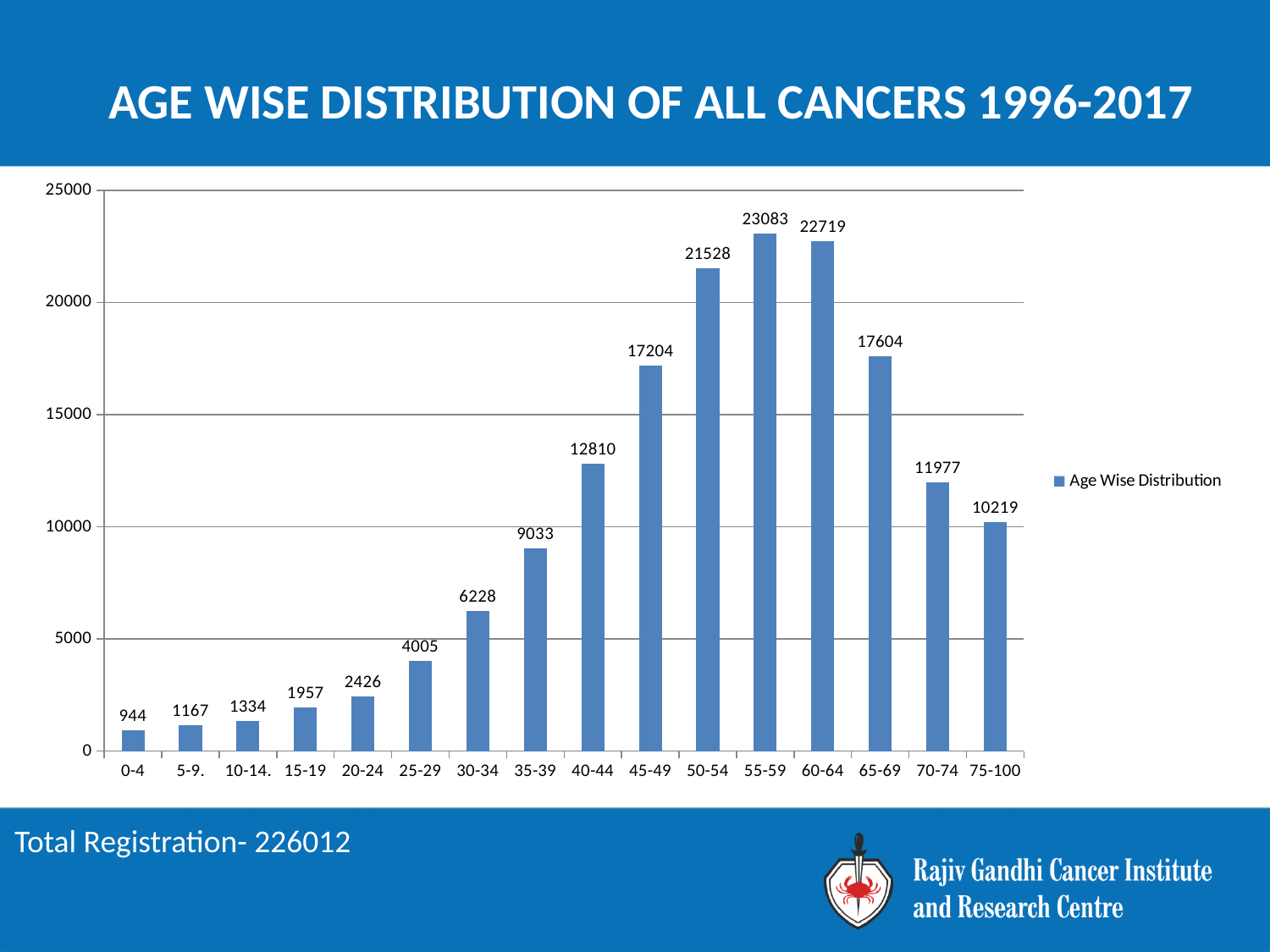
Which is larger, the value for 45-49 or the value for 65-69? 65-69 What is the value for the 0-4 age group? 944 What is the value for the 55-59 age group? 23083 Which age group has the lowest value? 0-4 What is the difference between the values for 55-59 and 60-64? 364 Is the value for 40-44 greater or less than 10000? greater What is the title of the chart? AGE WISE DISTRIBUTION OF ALL CANCERS 1996-2017 What kind of chart is shown on the slide? bar chart How many series does the legend list? 1 What is the value for the 75-100 age group? 10219 How many age groups are shown on the x axis? 16 Which age group has the highest value? 55-59